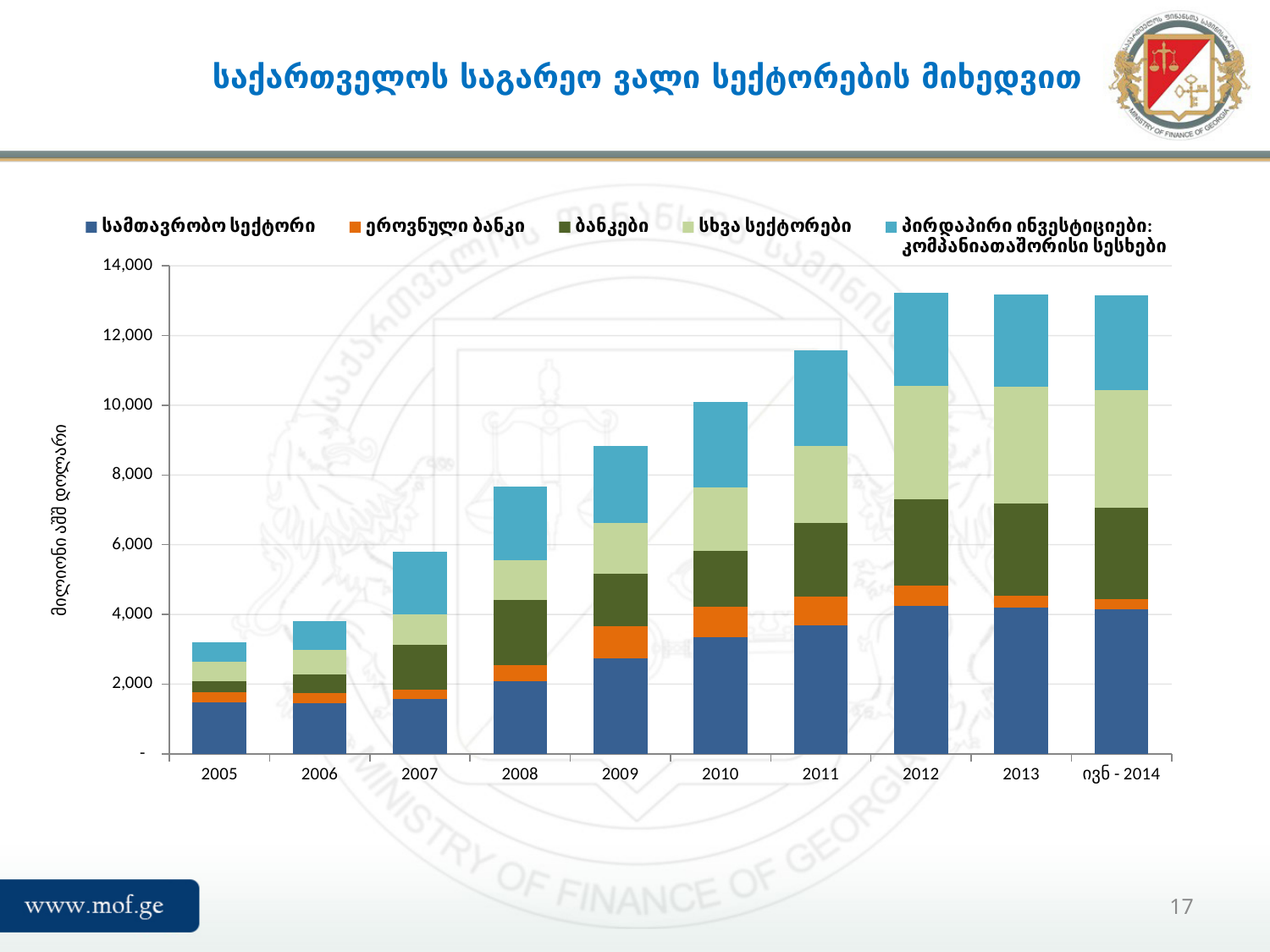
Is the total bar for 2005 greater or less than 4,000? less Is the total bar for 2011 greater or less than 11,000? greater Is the total bar for 2008 greater or less than 8,000? less Which period has the lowest total bar? 2005 Do the total bar heights rise or fall from 2005 to 2011? rise Which total bar is larger, 2010 or 2011? 2011 How many series does the legend list? 5 How many bars (time periods) are shown along the x axis? 10 What is the title of the chart? საქართველოს საგარეო ვალი სექტორების მიხედვით What is the label on the y axis? მილიონი აშშ დოლარი What kind of chart is shown on the slide? Stacked bar chart